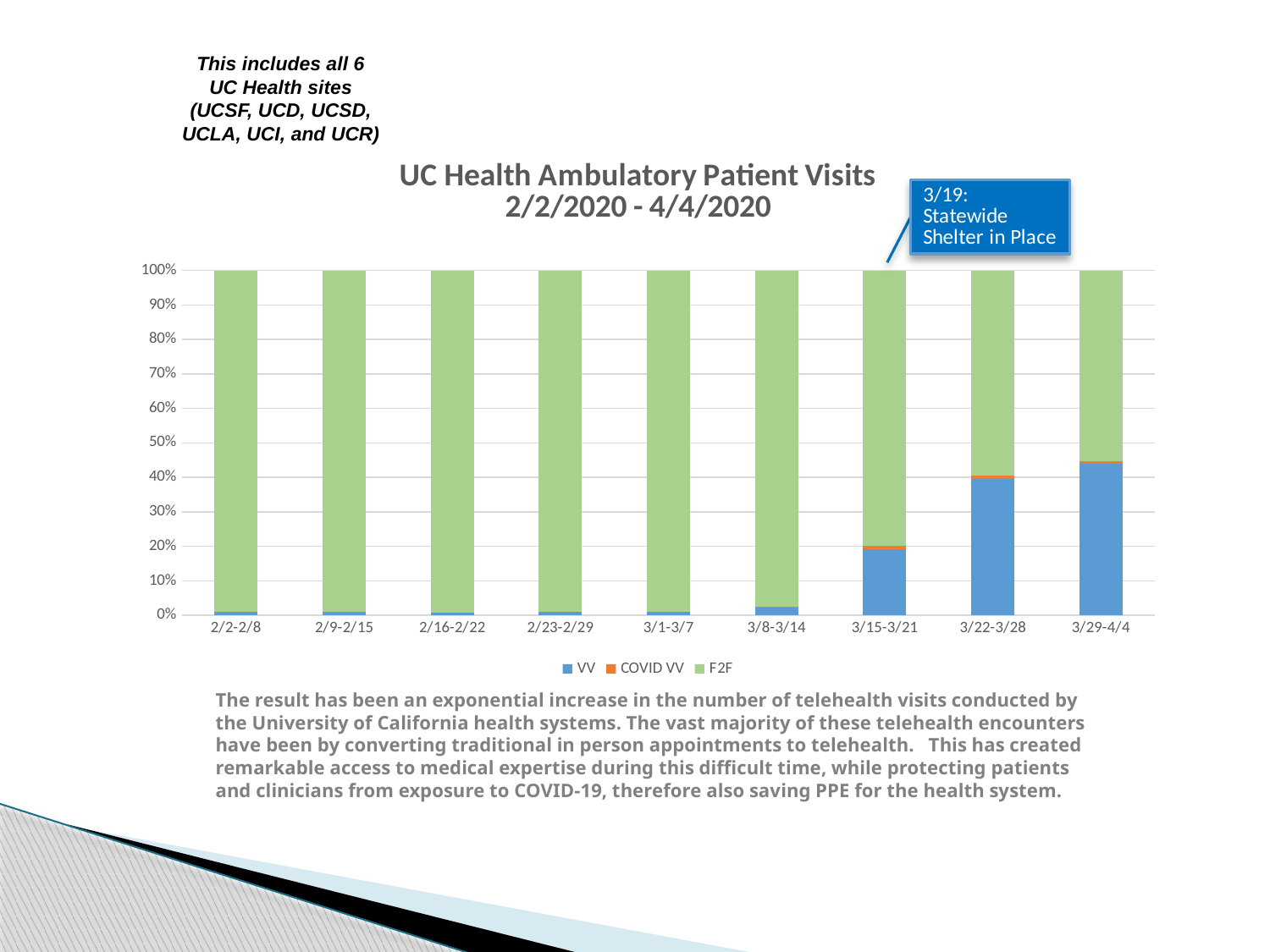
What kind of chart is shown on the slide? Bar chart Which week has the larger VV share, 3/15-3/21 or 3/22-3/28? 3/22-3/28 Is the F2F share for 3/29-4/4 greater or less than 50%? greater Which week has the highest VV share? 3/29-4/4 How many series does the chart's legend list? 3 How many weekly periods are shown on the x axis of the chart? 9 Is the VV share for 3/15-3/21 greater or less than 10%? greater Is the VV share for 3/29-4/4 greater or less than 30%? greater What are the three series named in the chart's legend? VV, COVID VV, F2F What event does the callout box on the chart mark? 3/19: Statewide Shelter in Place Does the VV share rise or fall across the weeks from 2/2-2/8 to 3/29-4/4? Rise